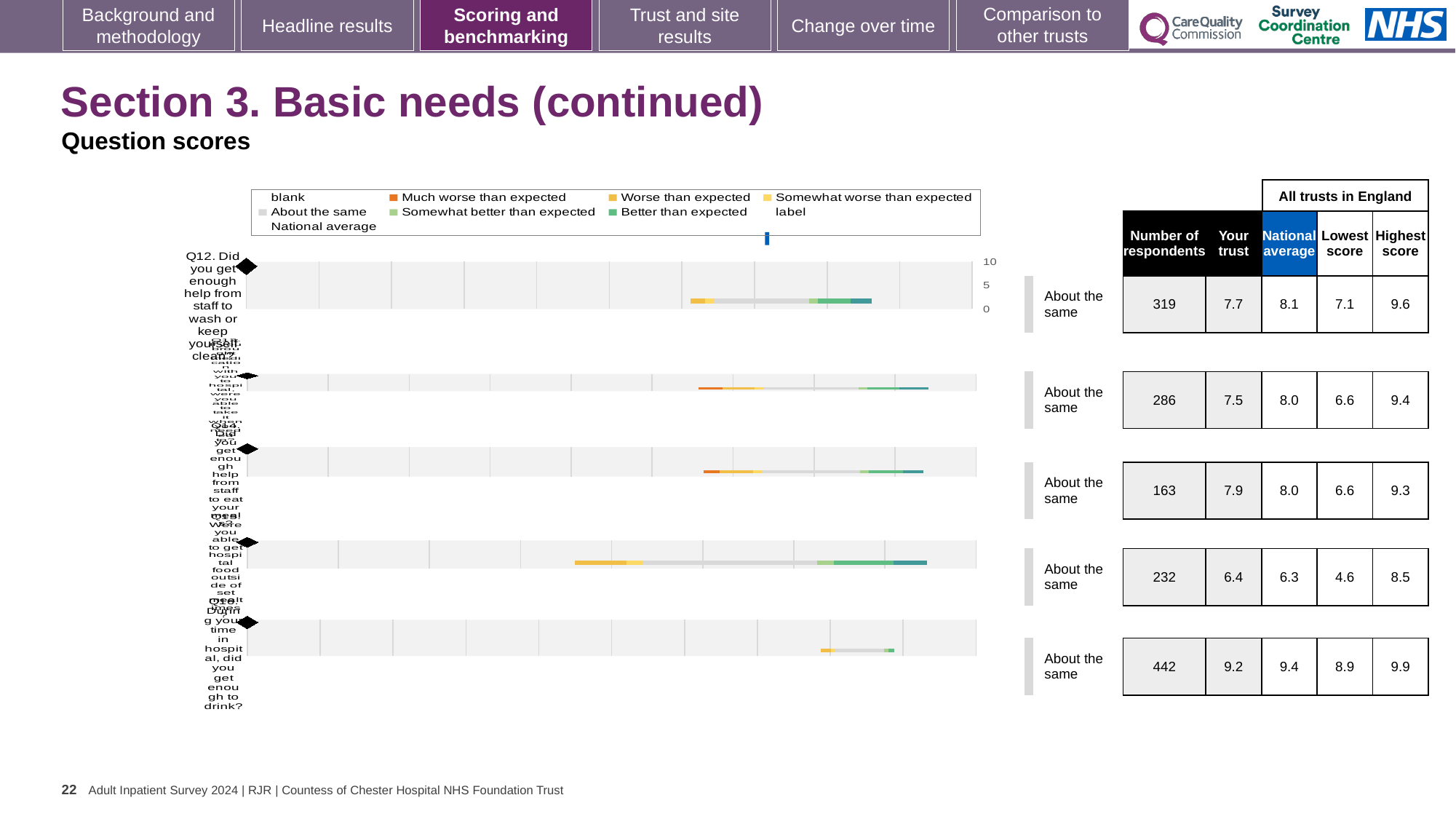
How many question rows are plotted in the chart? 5 What is the highest score among all trusts in England for Q16 (enough to drink)? 9.9 What is the 'Your trust' score for Q12 (help from staff to wash or keep yourself clean)? 7.7 What benchmark category is shown for Q12 (help from staff to wash or keep yourself clean)? About the same Which question row has the highest number of respondents? Q16 (enough to drink), 442 For Q15 (hospital food outside of set meal times), which is larger: the 'Your trust' score or the national average? Your trust (6.4) How many respondents are shown for Q12 (help from staff to wash or keep yourself clean)? 319 What is the national average score for Q12 (help from staff to wash or keep yourself clean)? 8.1 What is the difference between the national average and the 'Your trust' score for Q12? 0.4 What kind of chart is used to show the question scores? Bar chart Which question row has the lowest 'Your trust' score? Q15 (hospital food outside of set meal times), 6.4